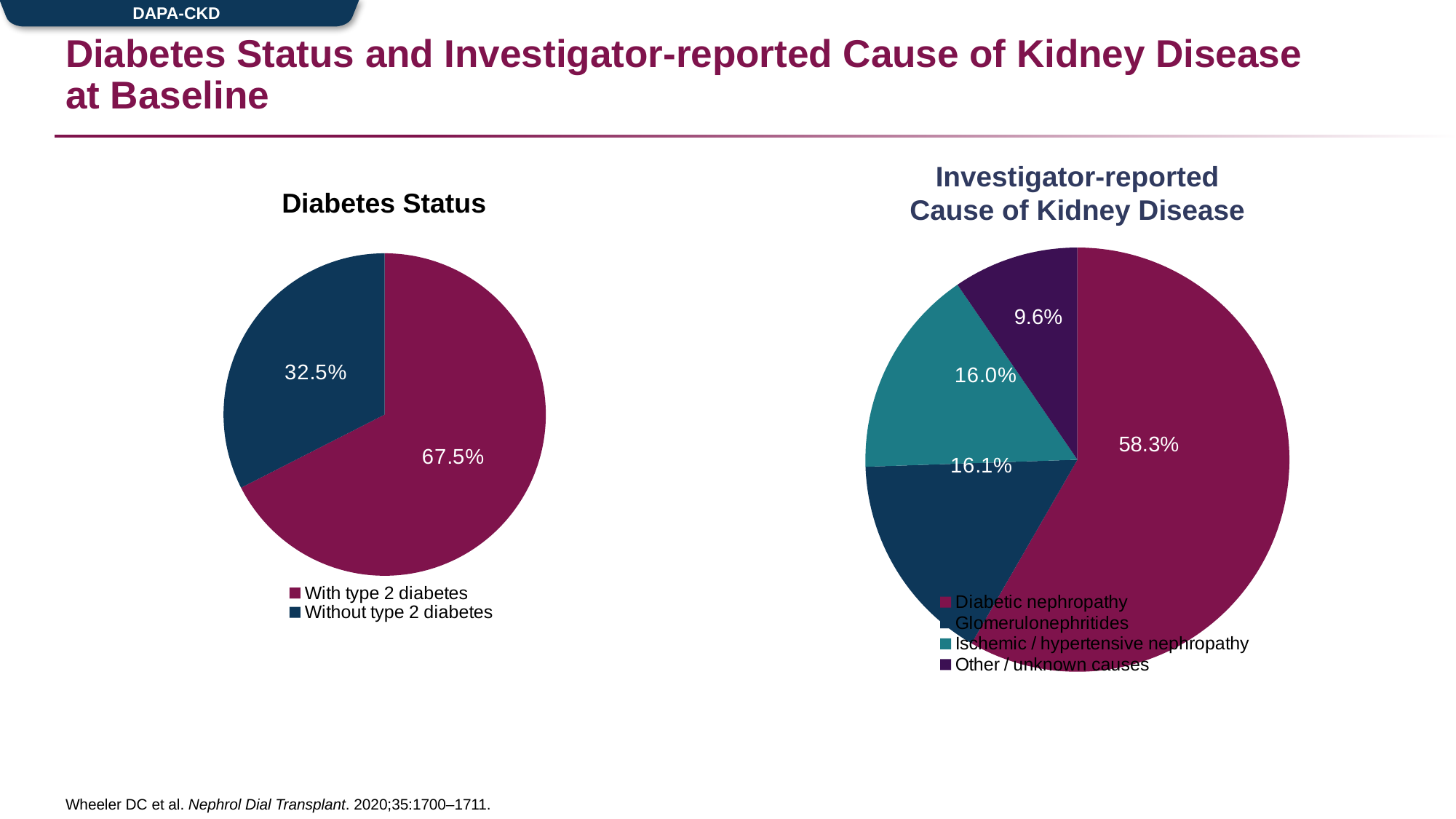
In the Investigator-reported Cause of Kidney Disease chart, what share is Diabetic nephropathy? 58.3% In the Investigator-reported Cause of Kidney Disease chart, what share is Other / unknown causes? 9.6% In the Diabetes Status chart, what share of patients were without type 2 diabetes? 32.5% In the Investigator-reported Cause of Kidney Disease chart, which cause has the smallest share? Other / unknown causes In the Investigator-reported Cause of Kidney Disease chart, how many categories does the legend list? 4 What kind of chart is the Diabetes Status chart? Pie chart In the Investigator-reported Cause of Kidney Disease chart, what is the difference between the Diabetic nephropathy share and the Glomerulonephritides share? 42.2% How many categories does the Diabetes Status chart show? 2 In the Diabetes Status chart, what is the difference between the share with type 2 diabetes and the share without? 35.0% In the Investigator-reported Cause of Kidney Disease chart, which cause has the largest share? Diabetic nephropathy